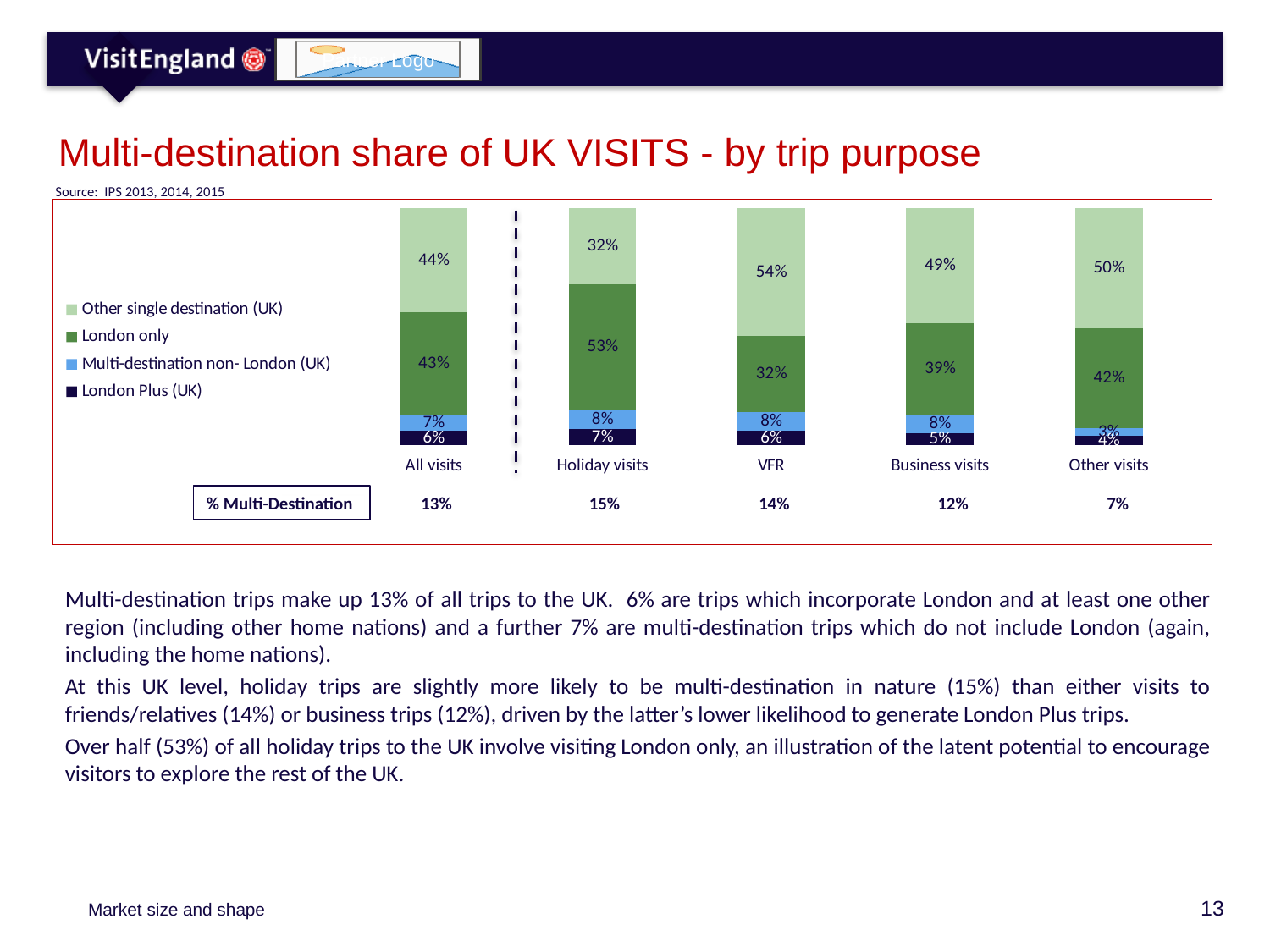
What is the value for Multi-destination non- London (UK) in the Business visits bar? 8% What is the % Multi-Destination figure shown for Business visits? 12% What is the value for London Plus (UK) in the All visits bar? 6% What is the difference between the Other single destination (UK) share for VFR and for Holiday visits? 22% Which is larger: the London only share for Business visits or for VFR? Business visits What kind of chart is shown on the slide? Stacked bar chart Which trip purpose has the highest London only share? Holiday visits What is the value for London only in the Holiday visits bar? 53% Which trip purpose has the lowest Other single destination (UK) share? Holiday visits How many trip purpose categories are shown on the x axis? 5 What is the value for Other single destination (UK) in the VFR bar? 54% How many series does the legend list? 4